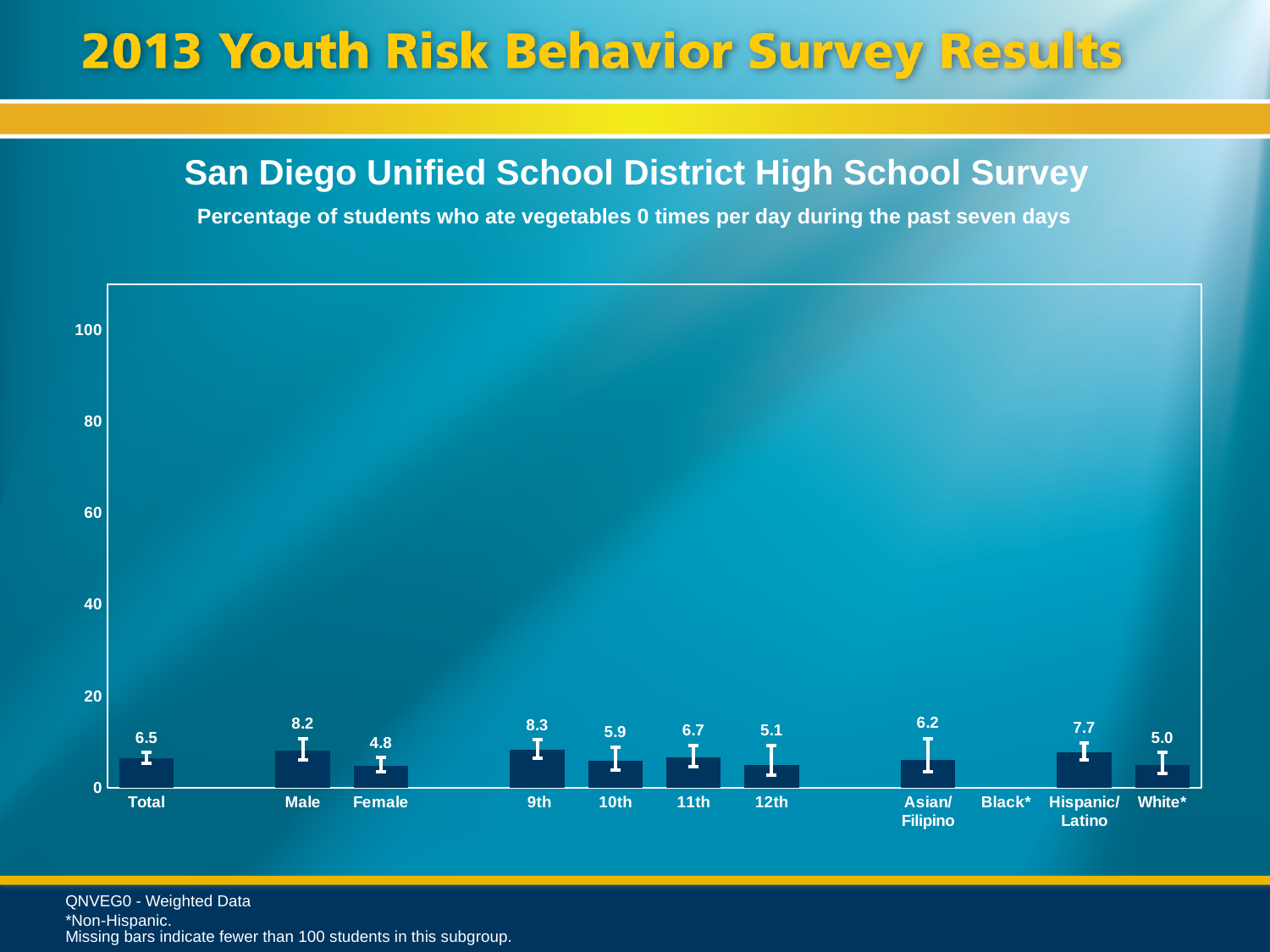
Among the grade levels (9th, 10th, 11th, 12th), which has the highest value? 9th Which is larger, the value for Asian/Filipino students or the value for White* students? Asian/Filipino What is the difference between the Male and Female values? 3.4 How many bars are plotted on the chart? 10 What is the value shown for Hispanic/Latino students? 7.7 What is the value shown for Female students? 4.8 What kind of chart is shown on the slide? bar chart Which category on the x axis has no bar plotted? Black* What is the value shown for Male students? 8.2 What percentage of students in the Total category ate vegetables 0 times per day during the past seven days? 6.5 What is the value shown for 12th grade students? 5.1 Is the value for 9th grade students greater or less than 20? less